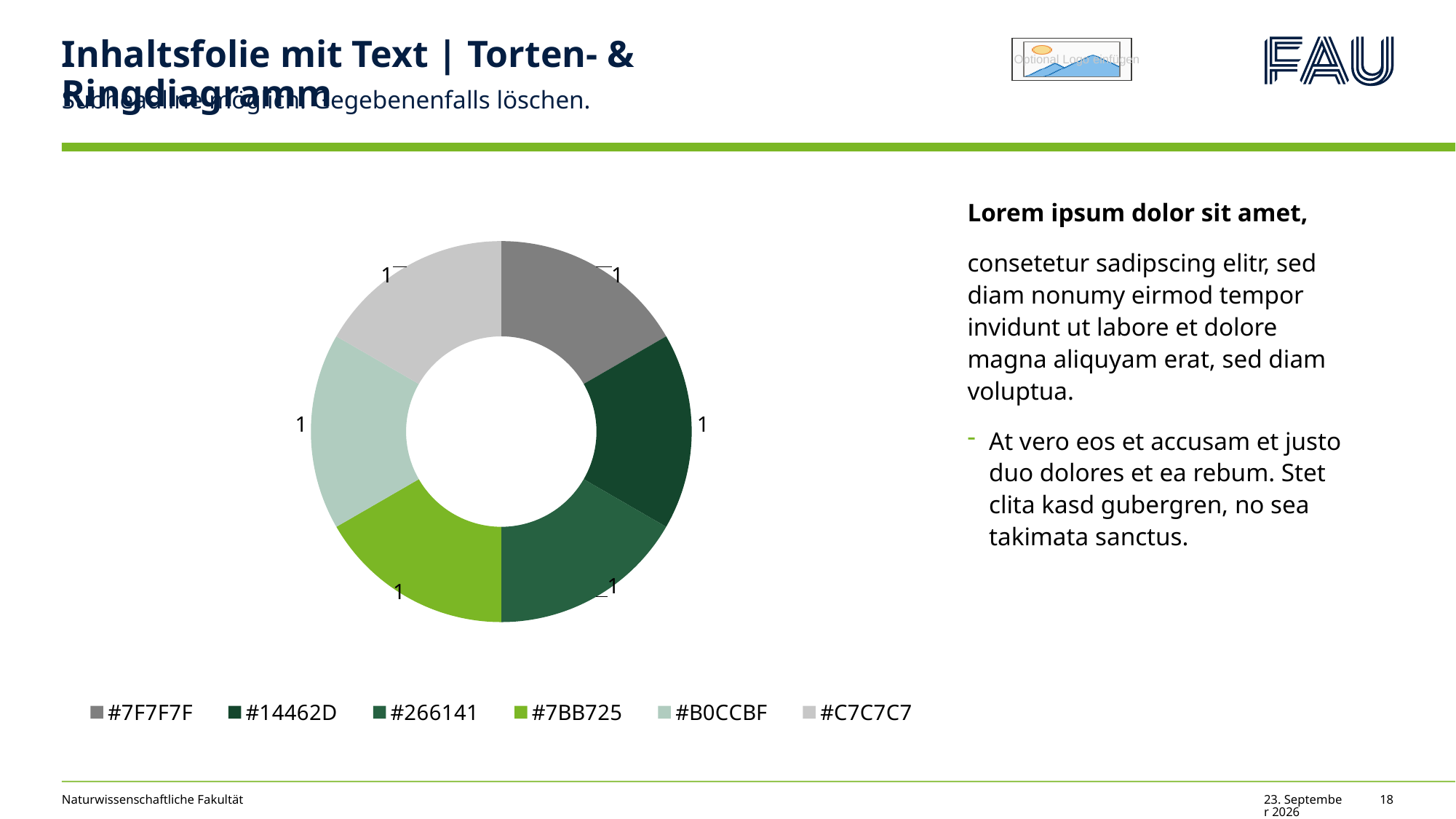
How many slices does the doughnut chart have? 6 What is the value of the #7BB725 slice in the doughnut chart? 1 Which legend entry is listed first in the doughnut chart's legend? #7F7F7F Which legend entry is listed last in the doughnut chart's legend? #C7C7C7 What kind of chart is shown on the slide? doughnut chart What is the value of the #7F7F7F slice in the doughnut chart? 1 What is the value of the #14462D slice in the doughnut chart? 1 Are the values of the #7F7F7F and #7BB725 slices equal, or is one larger? equal What is the difference between the values of the #266141 and #B0CCBF slices? 0 How many entries does the legend of the doughnut chart list? 6 What is the value of the #C7C7C7 slice in the doughnut chart? 1 What is the sum of all slice values in the doughnut chart? 6